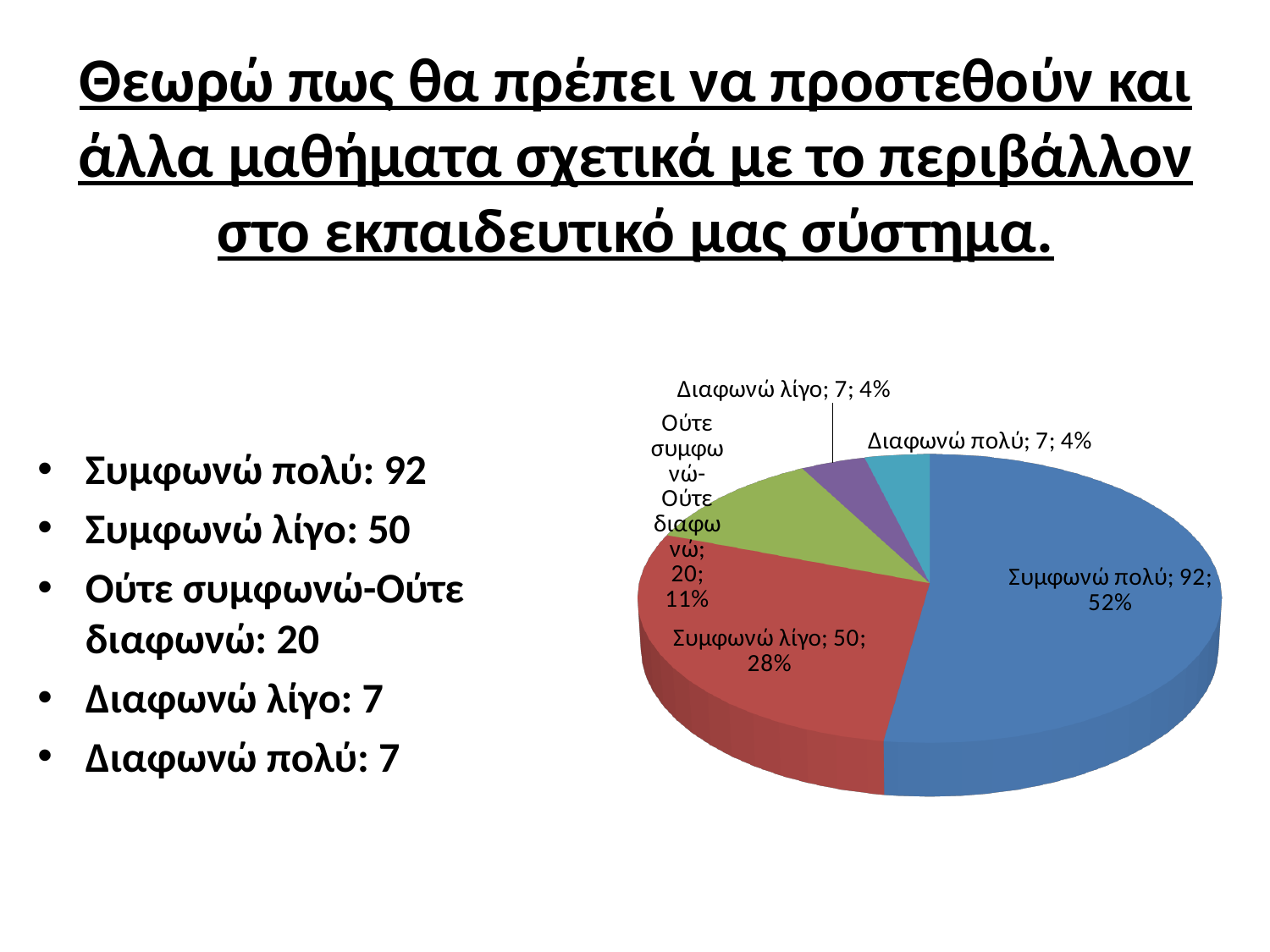
How many slices does the pie chart have? 5 What is the value for Συμφωνώ λίγο in the pie chart? 50 What share of the pie does Συμφωνώ λίγο represent? 28% What is the difference between the values for Συμφωνώ πολύ and Συμφωνώ λίγο? 42 What share of the pie does Διαφωνώ πολύ represent? 4% What is the value for Συμφωνώ πολύ in the pie chart? 92 What colour is the Συμφωνώ πολύ slice in the pie chart? Blue What kind of chart is shown on the slide? Pie chart What share of the pie does Συμφωνώ πολύ represent? 52% Which is larger, the value for Συμφωνώ λίγο or the value for Ούτε συμφωνώ-Ούτε διαφωνώ? Συμφωνώ λίγο Which category has the largest slice in the pie chart? Συμφωνώ πολύ What is the value for Ούτε συμφωνώ-Ούτε διαφωνώ in the pie chart? 20